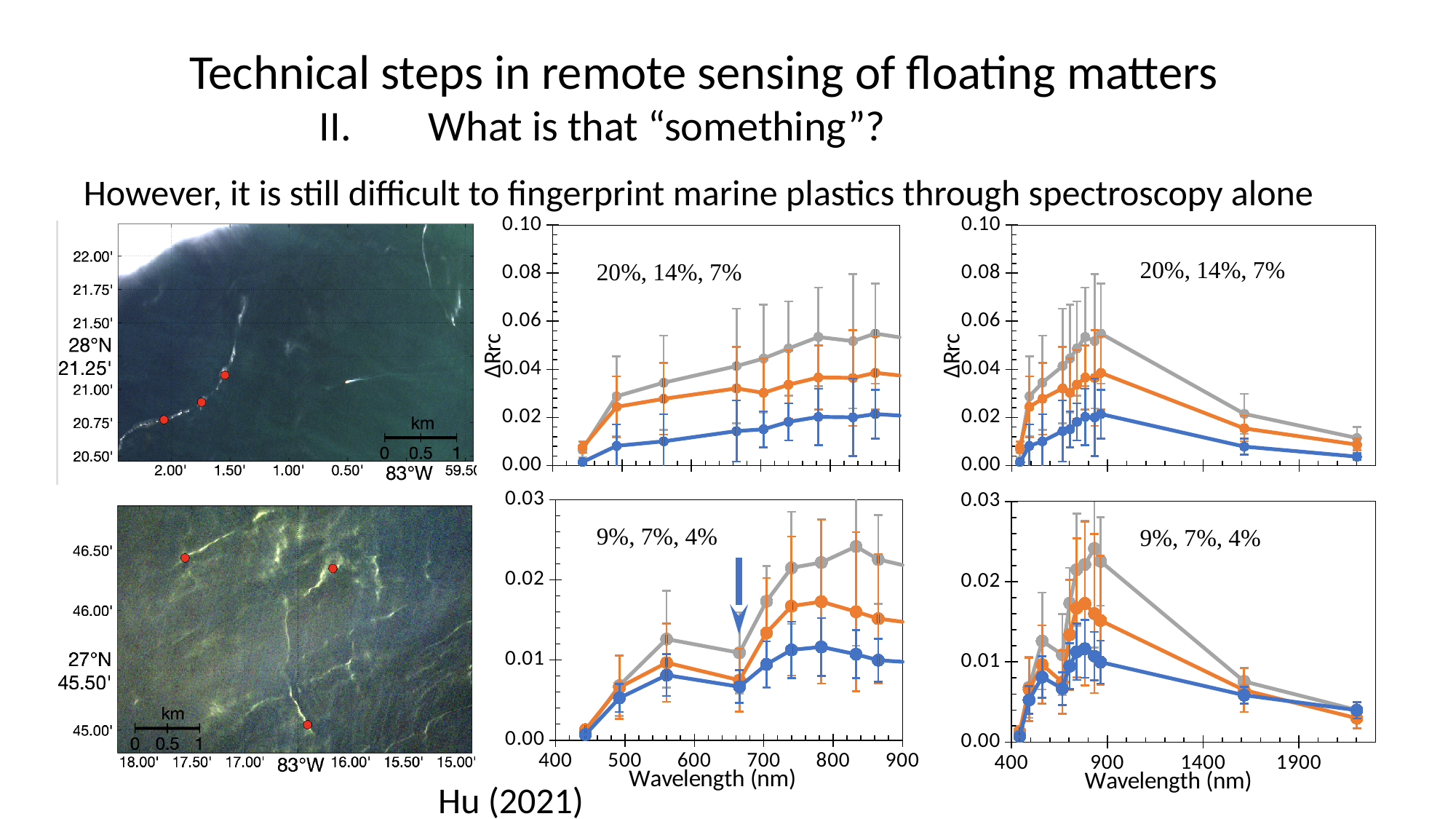
What kind of chart is the top-middle chart on the slide? line chart How many lines are plotted in the bottom-middle chart? 3 In the top-middle chart, which coloured line has the lowest values across the wavelengths? blue In the bottom-middle chart, is the peak value of the gray line greater or less than 0.02? greater In the bottom-right chart, is the value of the gray line at the longest wavelength (around 2100 nm) greater or less than 0.01? less What is the y-axis label of the charts on the slide? ΔRrc What percentages are annotated on the bottom-middle chart? 9%, 7%, 4% In the top-middle chart, at 900 nm, which line has the larger value, the gray line or the blue line? gray In the top-middle chart, is the value of the gray line at 900 nm greater or less than 0.04? greater In the top-middle chart, which coloured line has the highest values across the wavelengths? gray In the top-right chart, do the values of the gray line rise or fall between 900 nm and 1900 nm? fall